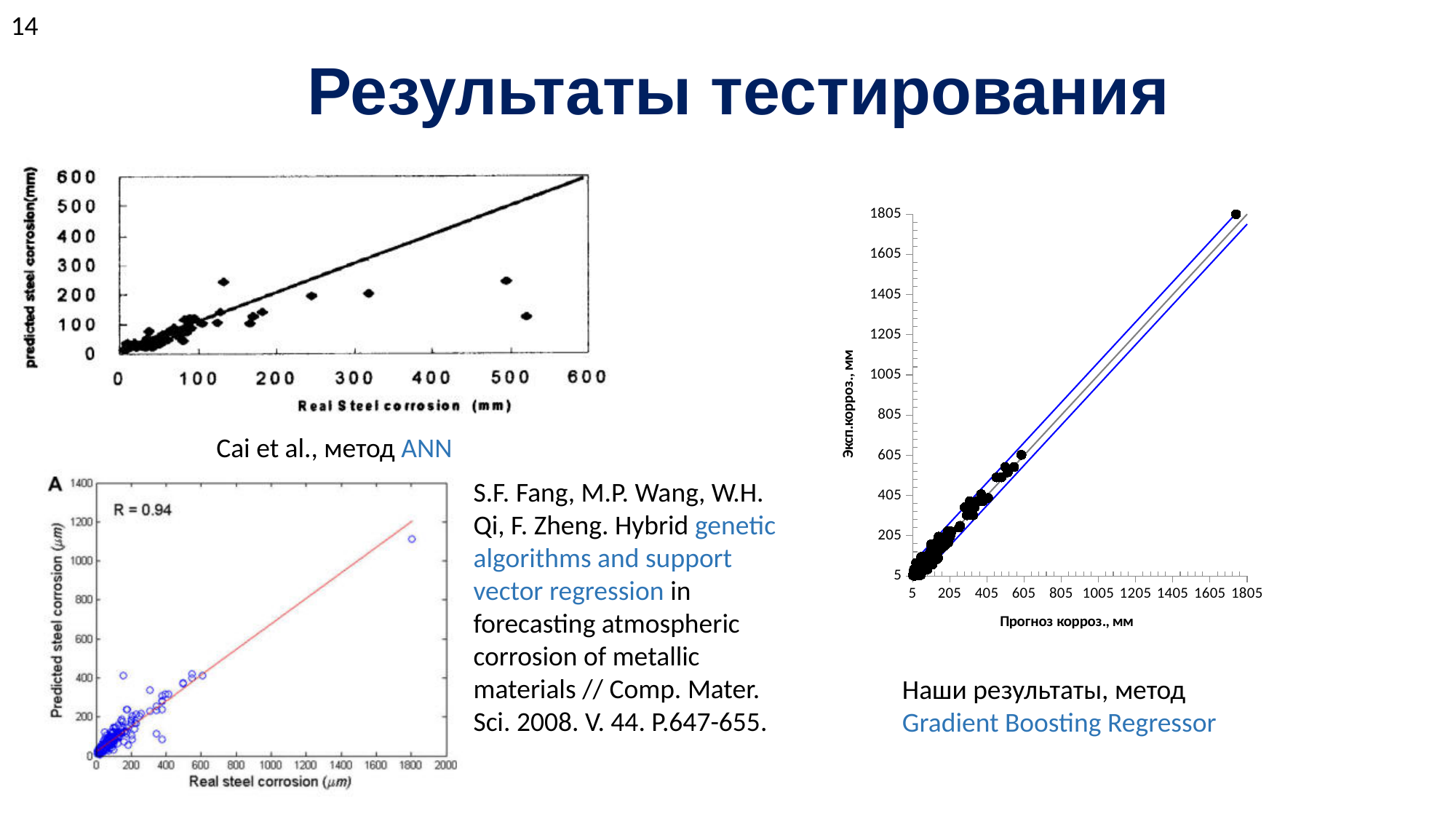
In the top-left chart (Cai et al., ANN), what is the highest tick value shown on the x axis 'Real Steel corrosion (mm)'? 600 In the right-hand chart (Gradient Boosting Regressor), is the experimental corrosion value of the topmost point greater or less than 1605? greater In the bottom-left chart (Fang et al.), what is the highest tick value shown on the y axis 'Predicted steel corrosion (μm)'? 1400 In the bottom-left chart (Fang et al.), what is the highest tick value shown on the x axis 'Real steel corrosion (μm)'? 2000 In the right-hand chart (Gradient Boosting Regressor), what is the label of the x axis? Прогноз корроз., мм In the bottom-left chart (Fang et al.), what correlation coefficient R is printed on the chart? R = 0.94 What kind of chart is the right-hand chart labelled 'Наши результаты, метод Gradient Boosting Regressor'? scatter plot What kind of chart is the top-left chart labelled 'Cai et al., метод ANN'? scatter plot In the top-left chart (Cai et al., ANN), is the predicted corrosion of the rightmost point (real corrosion just above 500) greater or less than 200? less In the right-hand chart (Gradient Boosting Regressor), what is the highest tick value shown on the y axis? 1805 In the bottom-left chart (Fang et al.), is the predicted corrosion of the point with real corrosion near 1800 greater or less than 1200? less In the right-hand chart (Gradient Boosting Regressor), do the plotted points rise or fall as the predicted corrosion on the x axis increases? rise